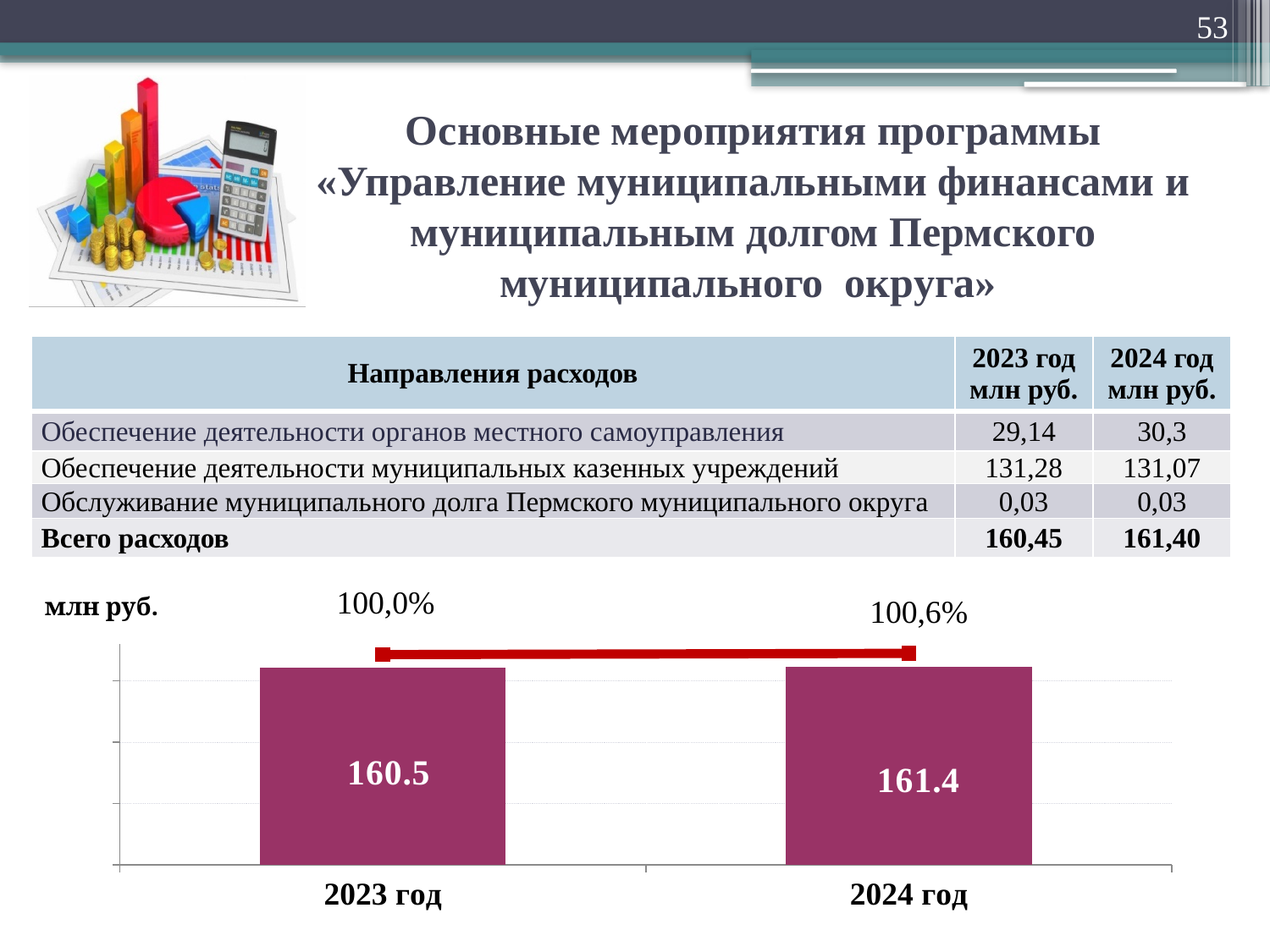
What percentage label is shown above the 2023 год bar? 100,0% What is the value shown for 2024 год in the bar chart? 161.4 Which year has the lower bar in the chart? 2023 год Is the bar for 2024 год larger or smaller than the bar for 2023 год? larger What percentage label is shown above the 2024 год bar? 100,6% What is the difference between the 2024 год and 2023 год bar values? 0.9 What kind of chart is shown at the bottom of the slide? bar chart How many bars are plotted in the chart? 2 Do the bar values rise or fall from 2023 год to 2024 год? rise Which year has the higher bar in the chart? 2024 год What unit is indicated at the top left of the chart? млн руб. What is the value shown for 2023 год in the bar chart? 160.5